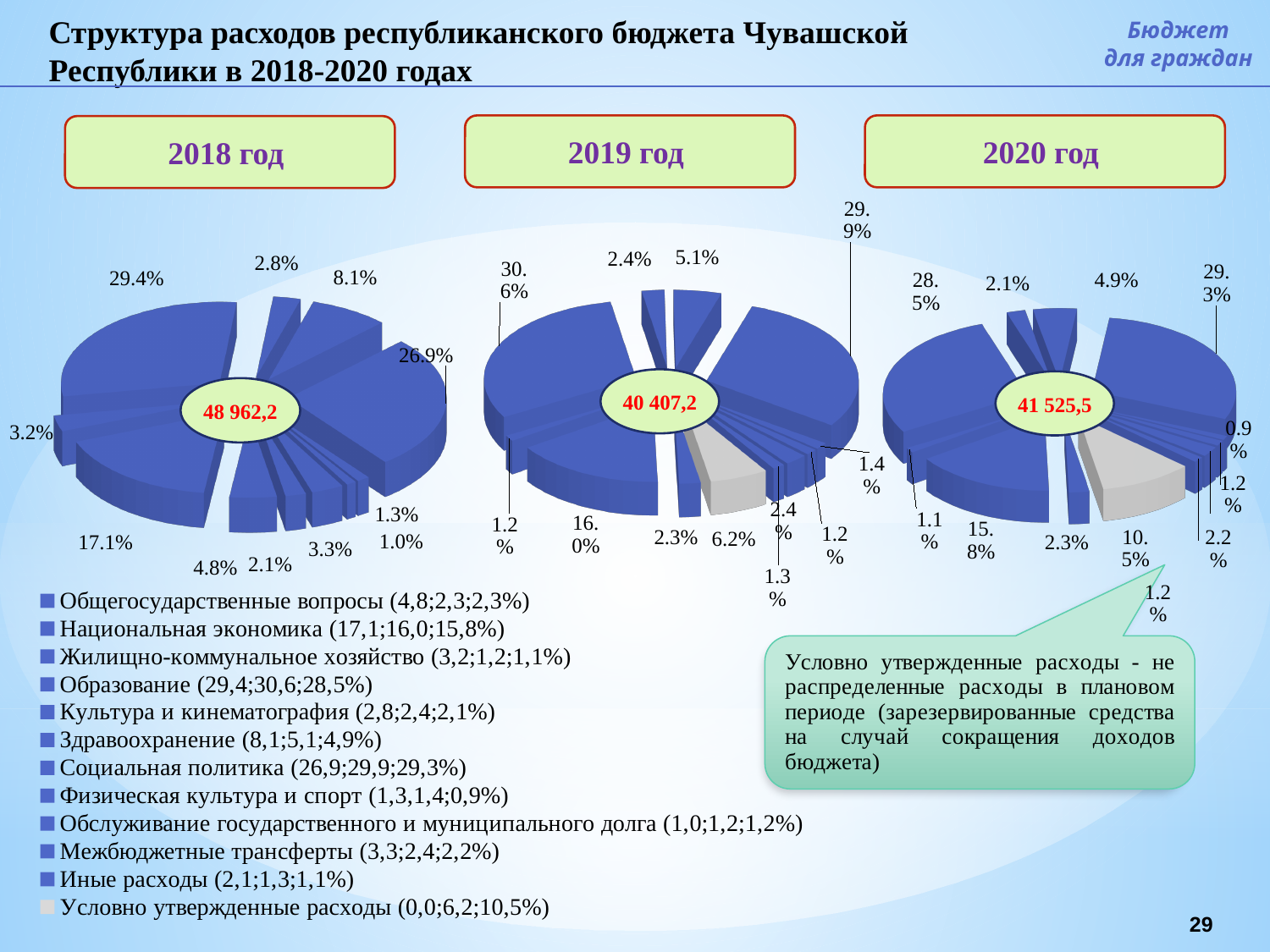
In the 2019 год chart, which category has the largest share? Образование In the 2018 год chart, what share does Образование have? 29.4% In the 2018 год chart, what is the difference between the shares of Образование and Социальная политика? 2.5 percentage points How many categories does the legend list? 12 In the 2020 год chart, which category has the largest share? Социальная политика What kind of chart is used for the 2018 год chart? pie chart In the 2019 год chart, what share does Условно утвержденные расходы have? 6.2% In the 2020 год chart, which is larger: the share of Национальная экономика or the share of Условно утвержденные расходы? Национальная экономика In the 2020 год chart, which category has the smallest share? Физическая культура и спорт In the 2020 год chart, what share does Социальная политика have? 29.3% What number is printed in the centre of the 2019 год chart? 40 407,2